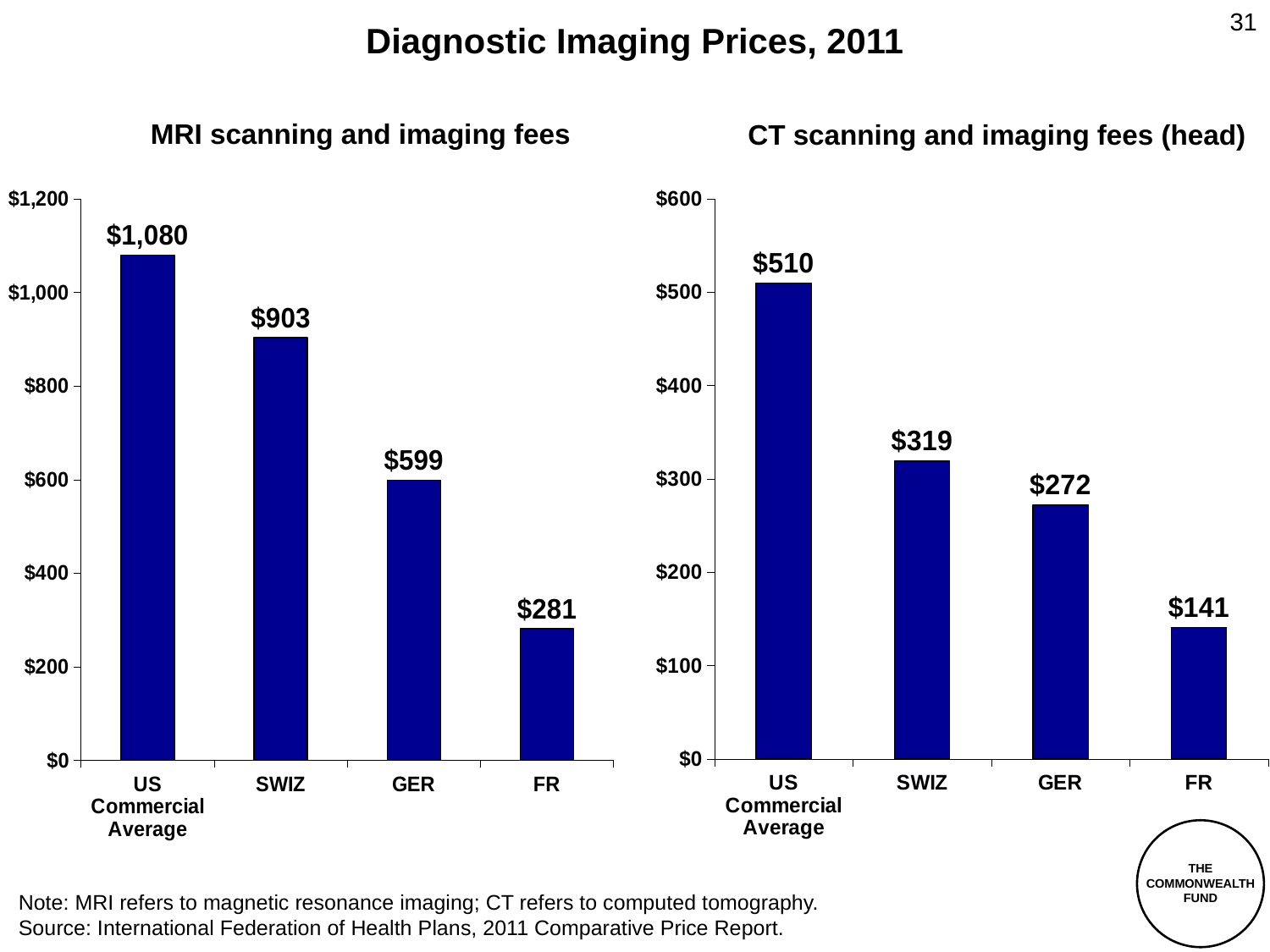
In the 'CT scanning and imaging fees (head)' chart, do the values rise or fall from left to right along the x axis? fall How many categories are shown in the 'CT scanning and imaging fees (head)' chart? 4 In the 'CT scanning and imaging fees (head)' chart, what is the value for GER? $272 In the 'MRI scanning and imaging fees' chart, is the value for GER greater or less than $800? less In the 'MRI scanning and imaging fees' chart, what is the value for SWIZ? $903 In the 'CT scanning and imaging fees (head)' chart, which is larger, the value for SWIZ or the value for FR? SWIZ What kind of chart is the 'MRI scanning and imaging fees' chart? bar chart In the 'CT scanning and imaging fees (head)' chart, what is the difference between the SWIZ and GER values? $47 What is the title of the chart on the right side of the slide? CT scanning and imaging fees (head) In the 'MRI scanning and imaging fees' chart, which category has the highest value? US Commercial Average In the 'MRI scanning and imaging fees' chart, what is the difference between the US Commercial Average and FR values? $799 In the 'CT scanning and imaging fees (head)' chart, which category has the lowest value? FR